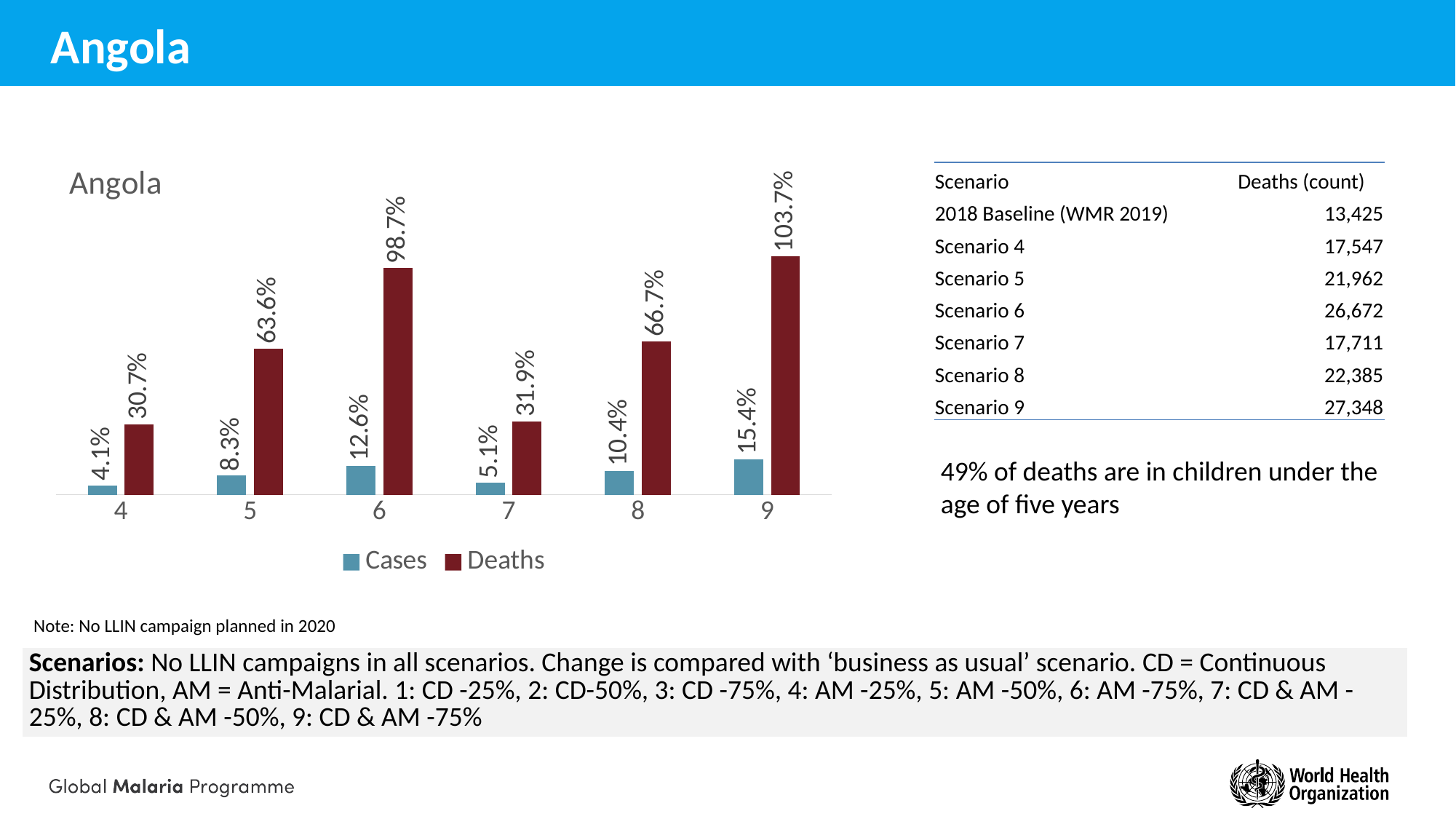
What kind of chart is shown on the slide? Bar chart How many series does the chart legend list? 2 What is the Cases value for scenario 4? 4.1% What is the difference between the Cases values for scenario 6 and scenario 7? 7.5% Which scenario has the highest Deaths value? 9 What colour are the Deaths bars in the chart? Dark red What is the difference between the Deaths values for scenario 9 and scenario 6? 5.0% What is the Deaths value for scenario 6? 98.7% Which is larger, the Deaths value for scenario 5 or for scenario 8? Scenario 8 What is the Cases value for scenario 9? 15.4% Which scenario has the lowest Cases value? 4 How many scenarios are shown on the x axis of the chart? 6